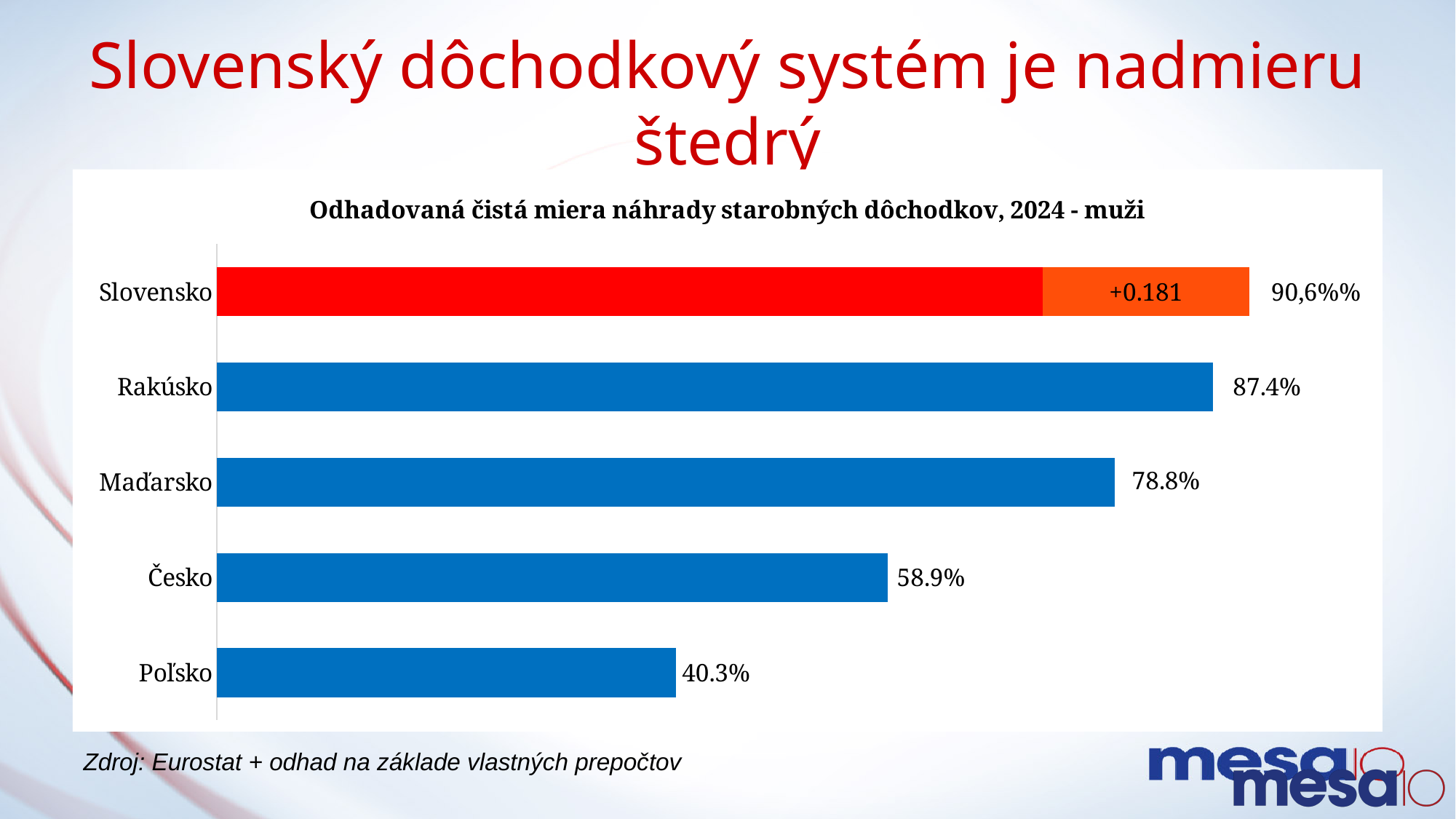
How many countries are shown in the chart? 5 What label is printed inside the orange segment of the Slovensko bar? +0.181 Which country has the lowest value in the chart? Poľsko What is the difference between the values for Česko and Poľsko? 18.6 percentage points Which has a larger value, Maďarsko or Česko? Maďarsko What is the value shown for Česko? 58.9% What is the value shown for Poľsko? 40.3% What is the value shown for Maďarsko? 78.8% What type of chart is shown on the slide? Bar chart Which country has the highest value in the chart? Slovensko What is the difference between the values for Rakúsko and Maďarsko? 8.6 percentage points What is the value shown for Rakúsko? 87.4%